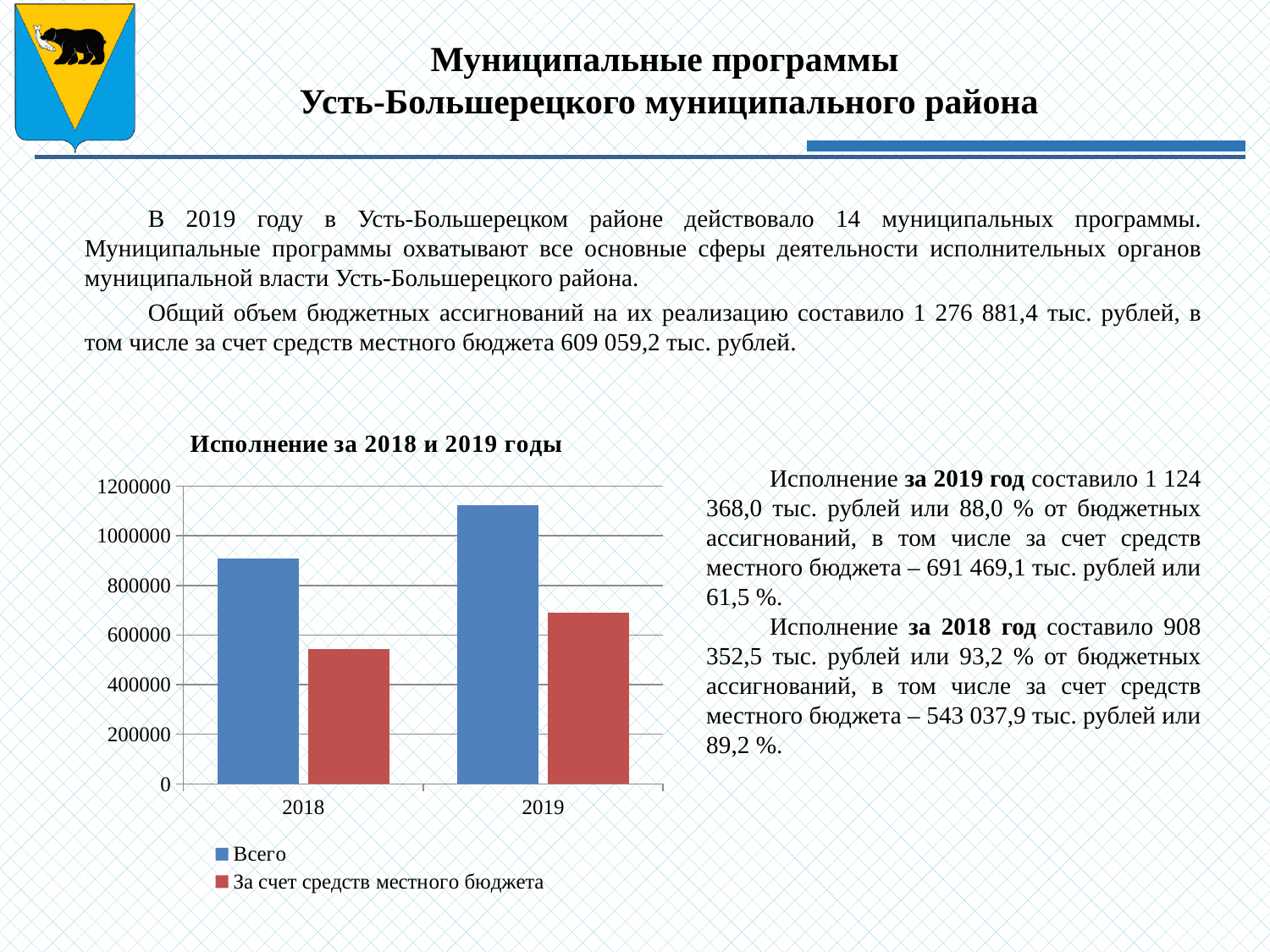
Which colour represents the "Всего" series in the chart? blue What kind of chart is shown under the title "Исполнение за 2018 и 2019 годы"? bar chart Is the value of the "За счет средств местного бюджета" bar for 2019 greater or less than 600000? greater Do the "Всего" values rise or fall from 2018 to 2019? rise How many series does the legend of the chart list? 2 Which year has the higher "Всего" bar in the chart? 2019 Is the value of the "За счет средств местного бюджета" bar for 2018 greater or less than 600000? less Which bar in the chart is the lowest? За счет средств местного бюджета, 2018 Is the value of the "Всего" bar for 2019 greater or less than 1000000? greater How many year categories are shown on the x axis of the chart? 2 What is the title of the chart on the slide? Исполнение за 2018 и 2019 годы